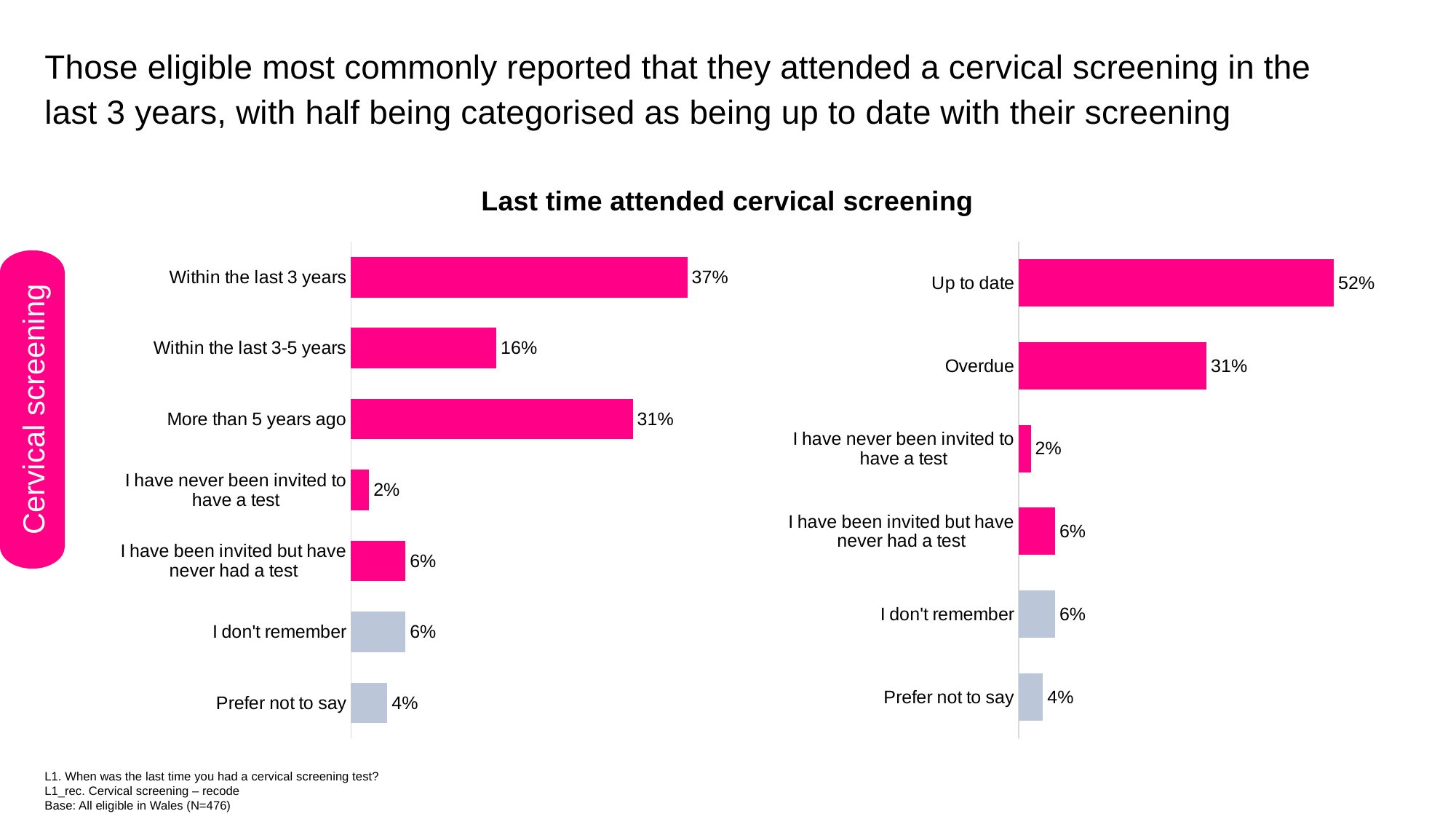
In the left chart, what percentage reported attending a cervical screening within the last 3 years? 37% In the right chart, what is the value for Overdue? 31% How many categories are shown in the left chart? 7 In the left chart, which category has the highest value? Within the last 3 years In the right chart, what percentage are categorised as Up to date? 52% In the right chart, which category has the lowest value? I have never been invited to have a test In the right chart, what is the difference between Up to date and Overdue? 21 percentage points In the left chart, what is the difference between 'Within the last 3 years' and 'Within the last 3-5 years'? 21 percentage points In the left chart, what is the value for 'More than 5 years ago'? 31% In the left chart, which is larger: 'Within the last 3-5 years' or 'More than 5 years ago'? More than 5 years ago In the left chart, which category has the lowest value? I have never been invited to have a test What type of chart is used on this slide? Bar chart